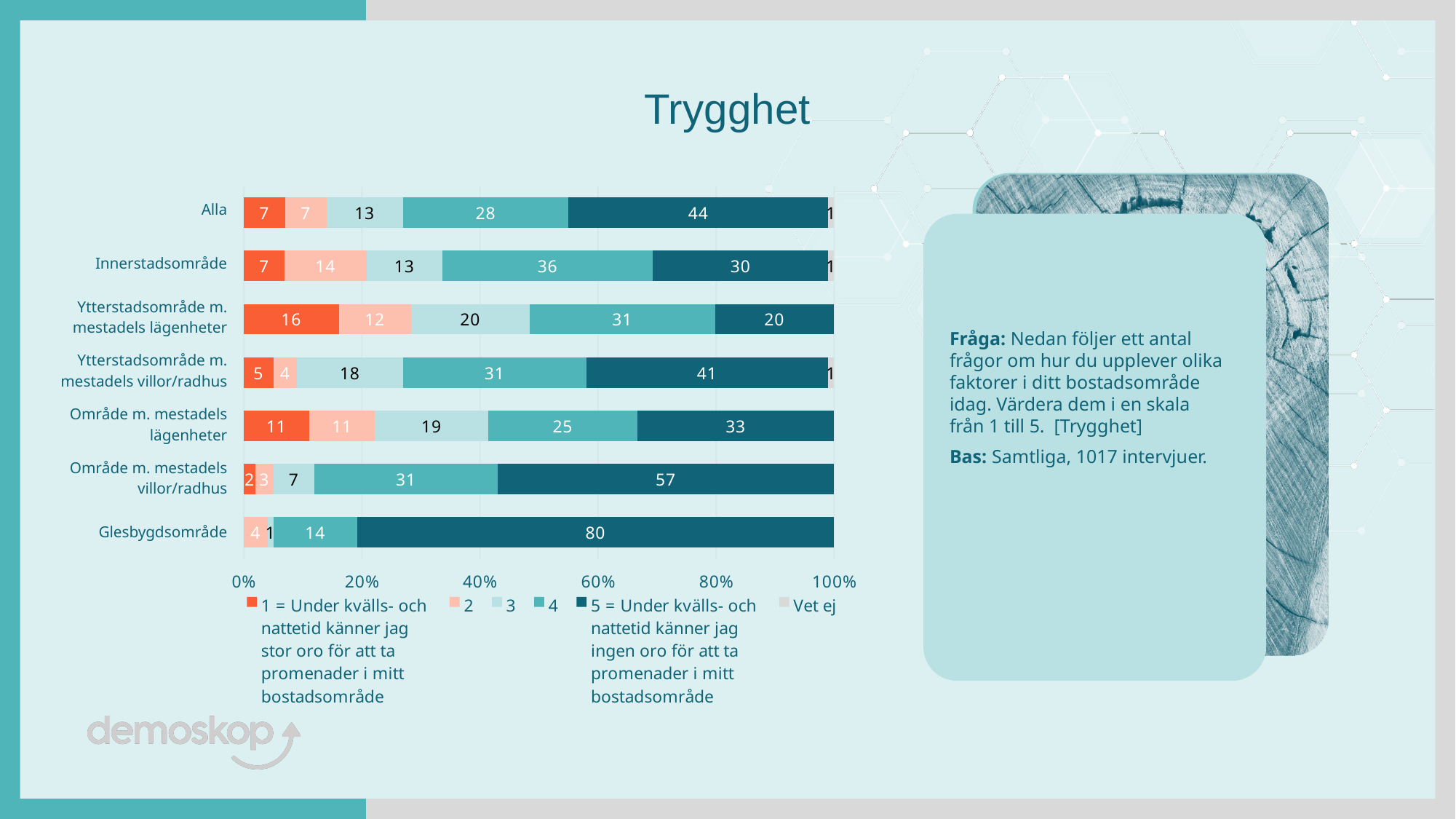
What is the value for series 3 for Ytterstadsområde m. mestadels villor/radhus? 18 How many series does the legend list? 6 Which is larger for Alla: the value for series 4 or the value for series 5? Series 5 (44) What is the title of the chart? Trygghet Which category has the highest value for series 5 (ingen oro)? Glesbygdsområde What kind of chart is shown on the slide? Stacked bar chart How many categories (area types) are shown on the chart? 7 What is the value for series 1 (stor oro) for Ytterstadsområde m. mestadels lägenheter? 16 What is the value for series 5 (ingen oro) for Glesbygdsområde? 80 What is the value for series 4 for Innerstadsområde? 36 Which category has the lowest value for series 5 (ingen oro)? Ytterstadsområde m. mestadels lägenheter What is the difference between the series 5 values for Område m. mestadels villor/radhus and Område m. mestadels lägenheter? 24